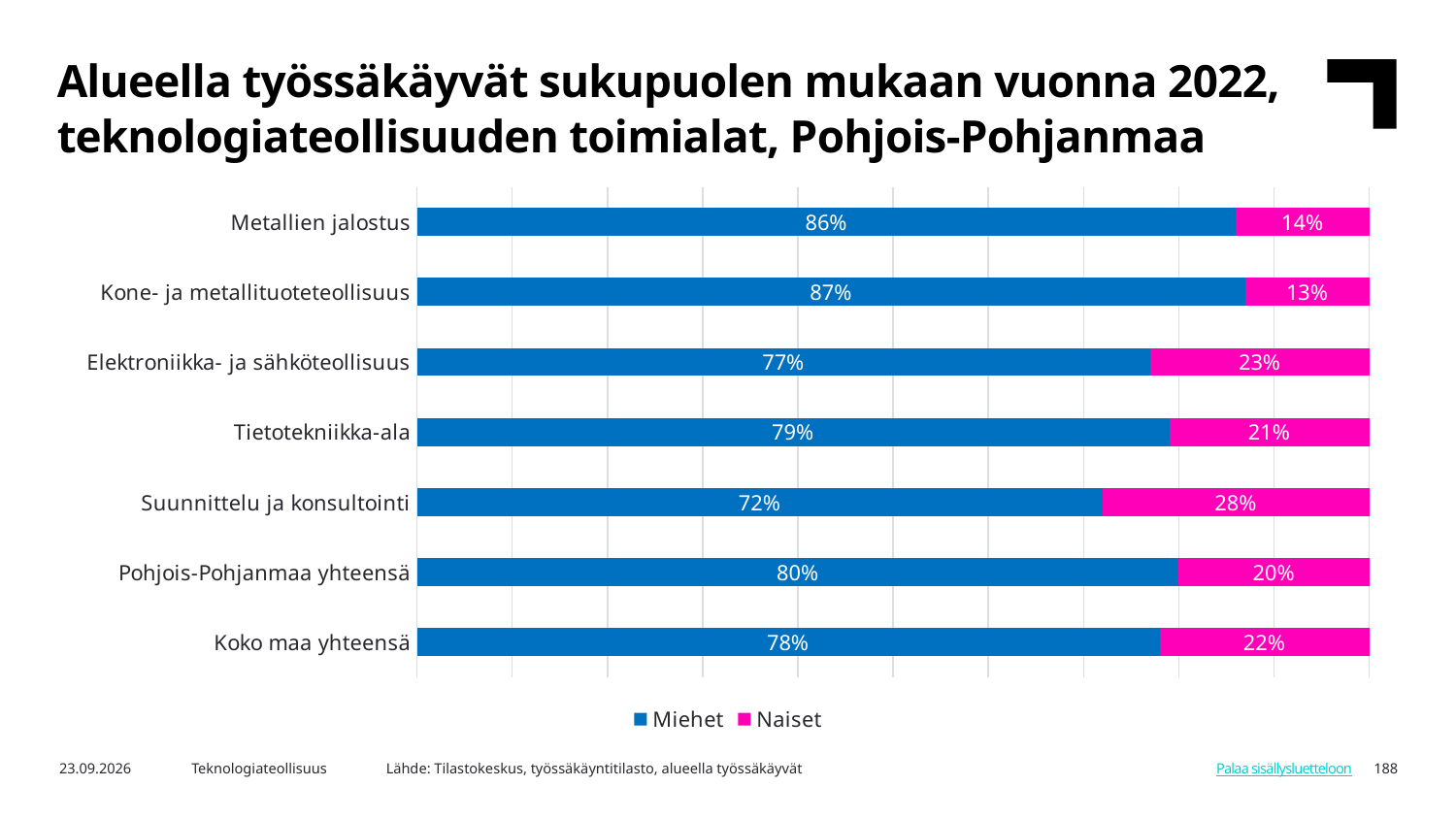
What is the Naiset share for Suunnittelu ja konsultointi? 28% Which category has the lowest Naiset share? Kone- ja metallituoteteollisuus What kind of chart is shown on the slide? Stacked bar chart What is the Miehet share for Metallien jalostus? 86% How many series does the legend list? 2 What is the total of the stacked bar for Suunnittelu ja konsultointi? 100% Which category has the highest Miehet share? Kone- ja metallituoteteollisuus What is the Miehet share for Tietotekniikka-ala? 79% How many categories are shown on the chart? 7 What is the difference between the Naiset share for Elektroniikka- ja sähköteollisuus and for Metallien jalostus? 9 percentage points Which is larger: the Naiset share for Pohjois-Pohjanmaa yhteensä or for Koko maa yhteensä? Koko maa yhteensä What is the Naiset share for Koko maa yhteensä? 22%